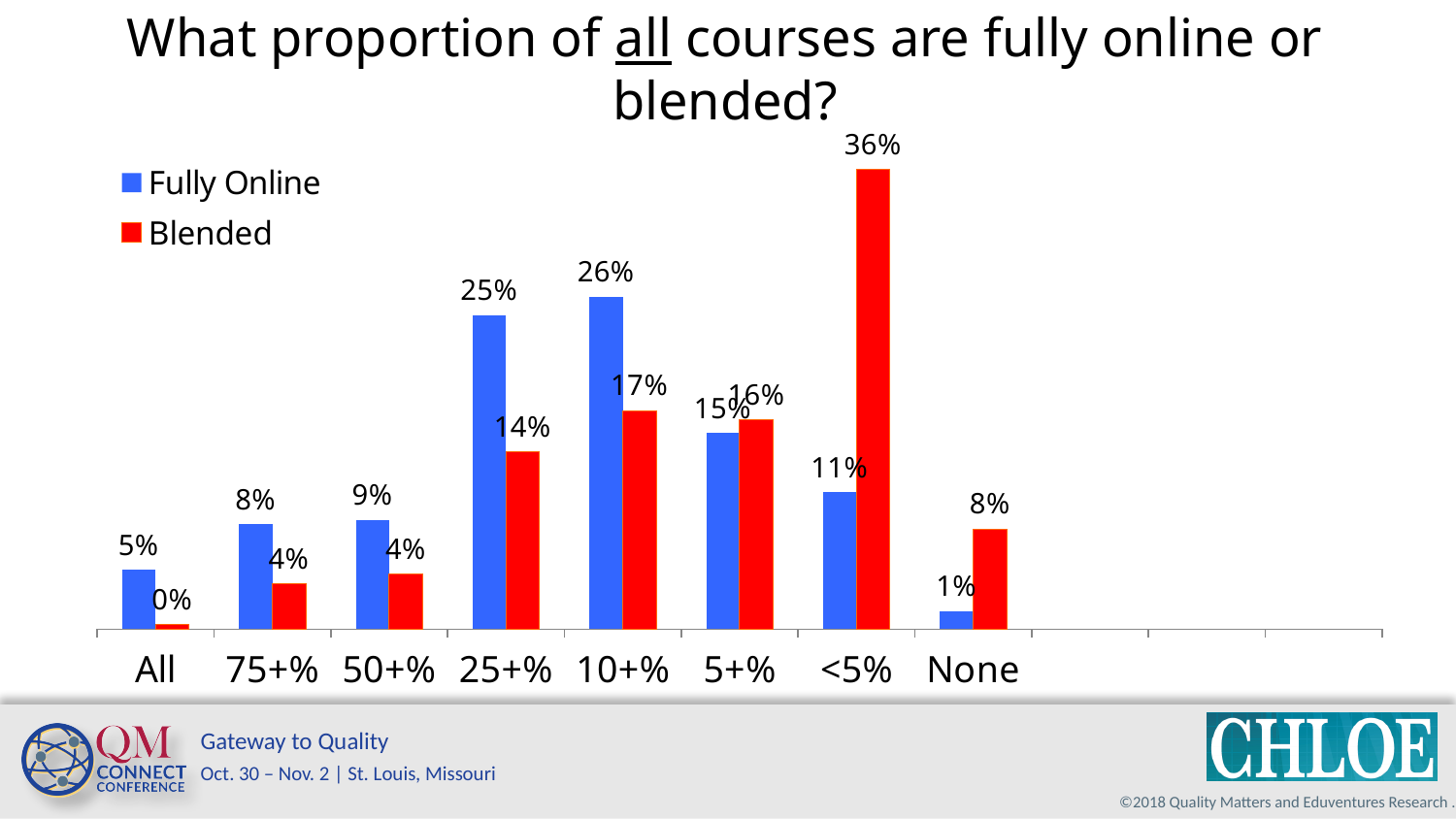
What is the Fully Online value for the 25+% category? 25% Which category has the lowest Blended value? All What colour represents the Blended series? Red How many series does the legend list? 2 What is the Fully Online value for the None category? 1% What is the Blended value for the All category? 0% What is the difference between the Blended and Fully Online values for the <5% category? 25% Which category has the highest Fully Online value? 10+% What kind of chart is shown on the slide? Bar chart For the 10+% category, which is larger: Fully Online or Blended? Fully Online How many categories are shown on the x axis? 8 What is the Blended value for the <5% category? 36%